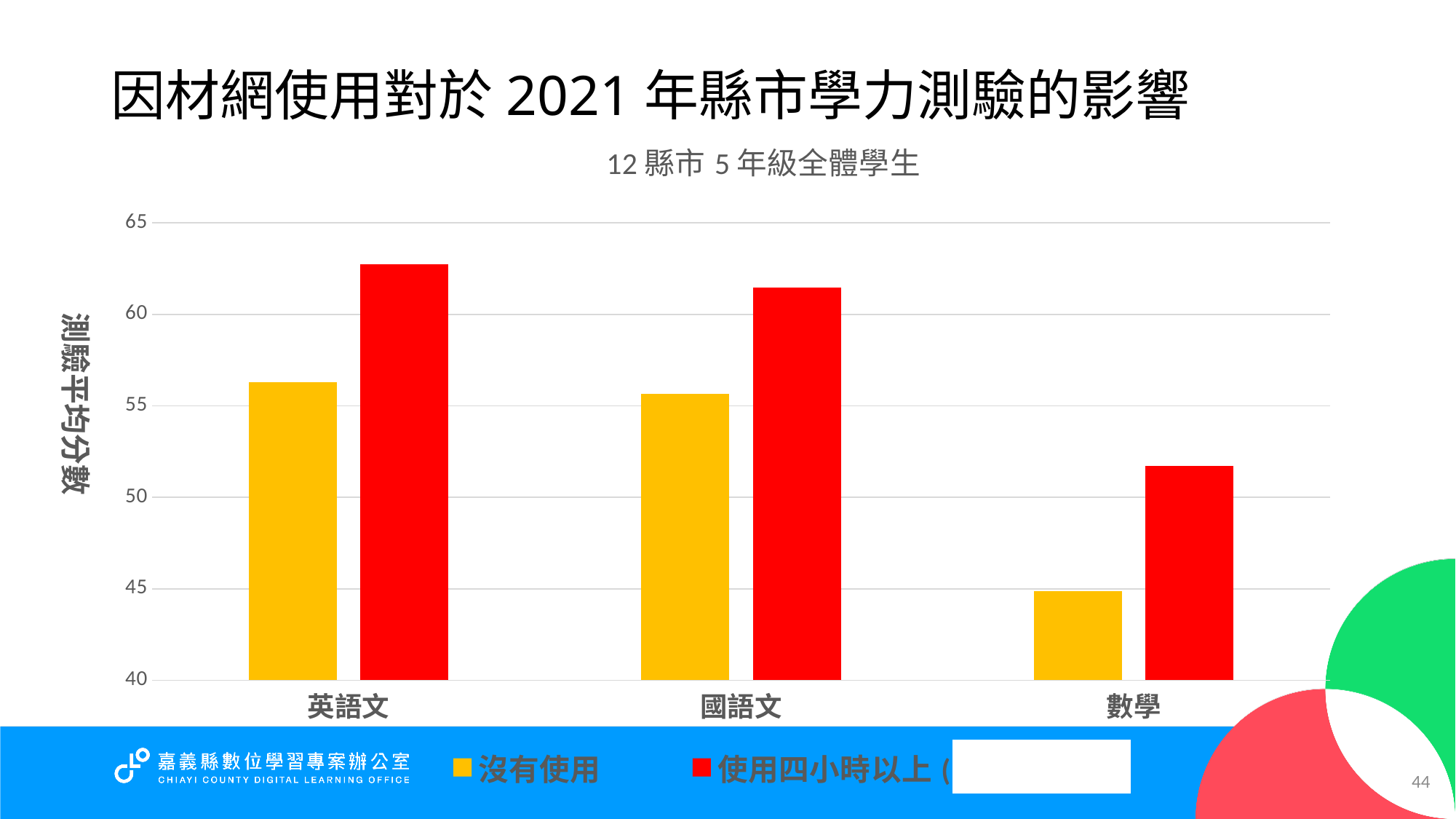
Is the value for 數學 in the 使用四小時以上 series greater or less than 50? greater Is the value for 國語文 in the 使用四小時以上 series greater or less than 60? greater How many series does the legend list? 2 What kind of chart is shown on the slide? bar chart Is the value for 數學 in the 沒有使用 series greater or less than 50? less How many subject categories are shown on the x axis? 3 Which subject has the lowest bar for 沒有使用? 數學 What is the label of the vertical axis? 測驗平均分數 For 數學, which series has the larger value: 沒有使用 or 使用四小時以上? 使用四小時以上 What colour represents the 沒有使用 series? yellow Which subject has the highest bar for 使用四小時以上? 英語文